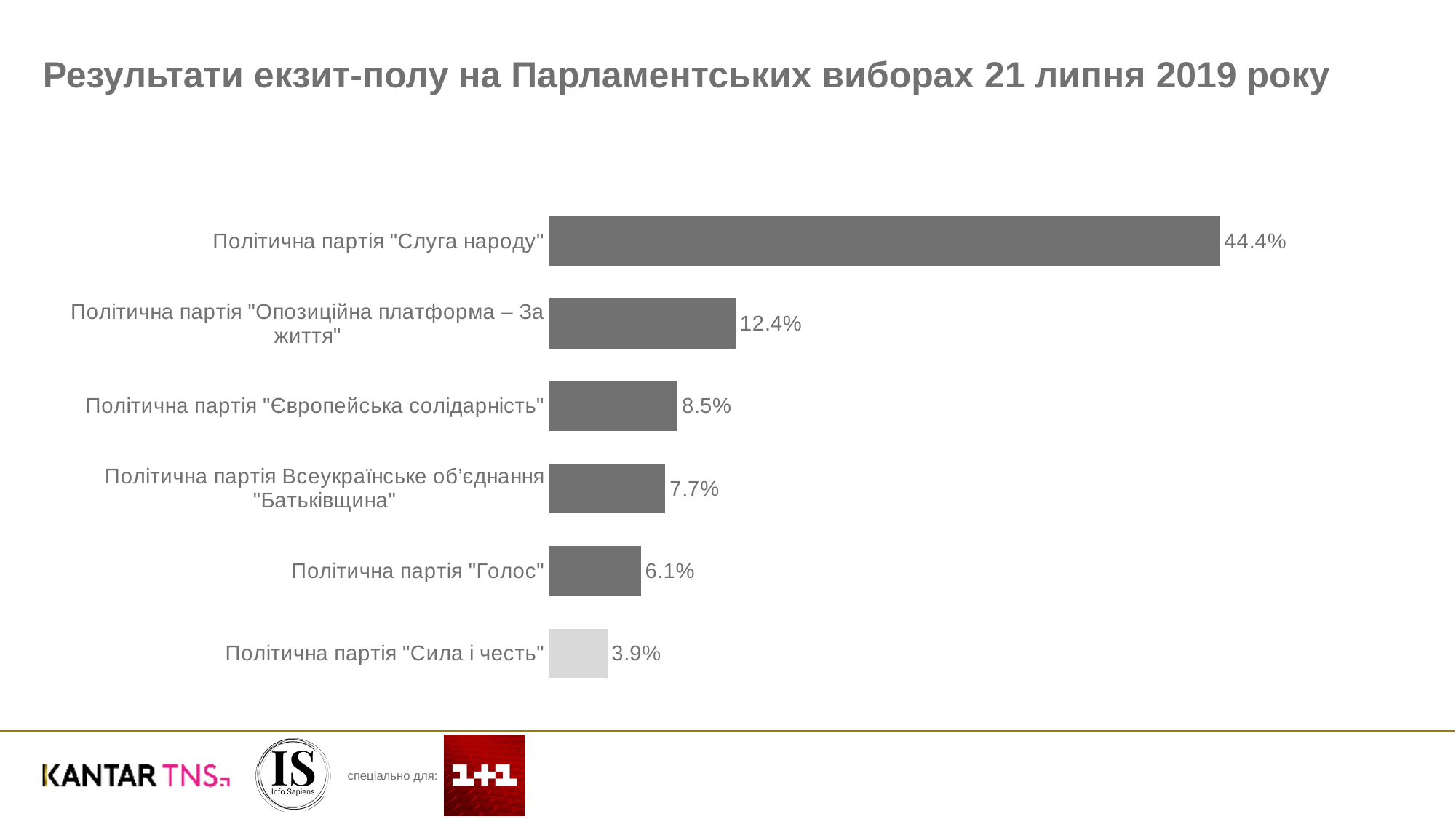
What value is shown for Політична партія "Голос"? 6.1% What is the difference between the values for Політична партія "Слуга народу" and Політична партія "Опозиційна платформа – За життя"? 32.0% What value is shown for Політична партія "Опозиційна платформа – За життя"? 12.4% What kind of chart is shown on the slide? Bar chart Which party has the highest value on the chart? Політична партія "Слуга народу" What is the difference between the values for Політична партія "Європейська солідарність" and Політична партія Всеукраїнське об’єднання "Батьківщина"? 0.8% What value is shown for Політична партія "Слуга народу"? 44.4% What is the title of the slide? Результати екзит-полу на Парламентських виборах 21 липня 2019 року How many parties are shown on the chart? 6 Which has a larger value: Політична партія "Голос" or Політична партія "Сила і честь"? Політична партія "Голос" Which party has the lowest value on the chart? Політична партія "Сила і честь" What value is shown for Політична партія "Європейська солідарність"? 8.5%